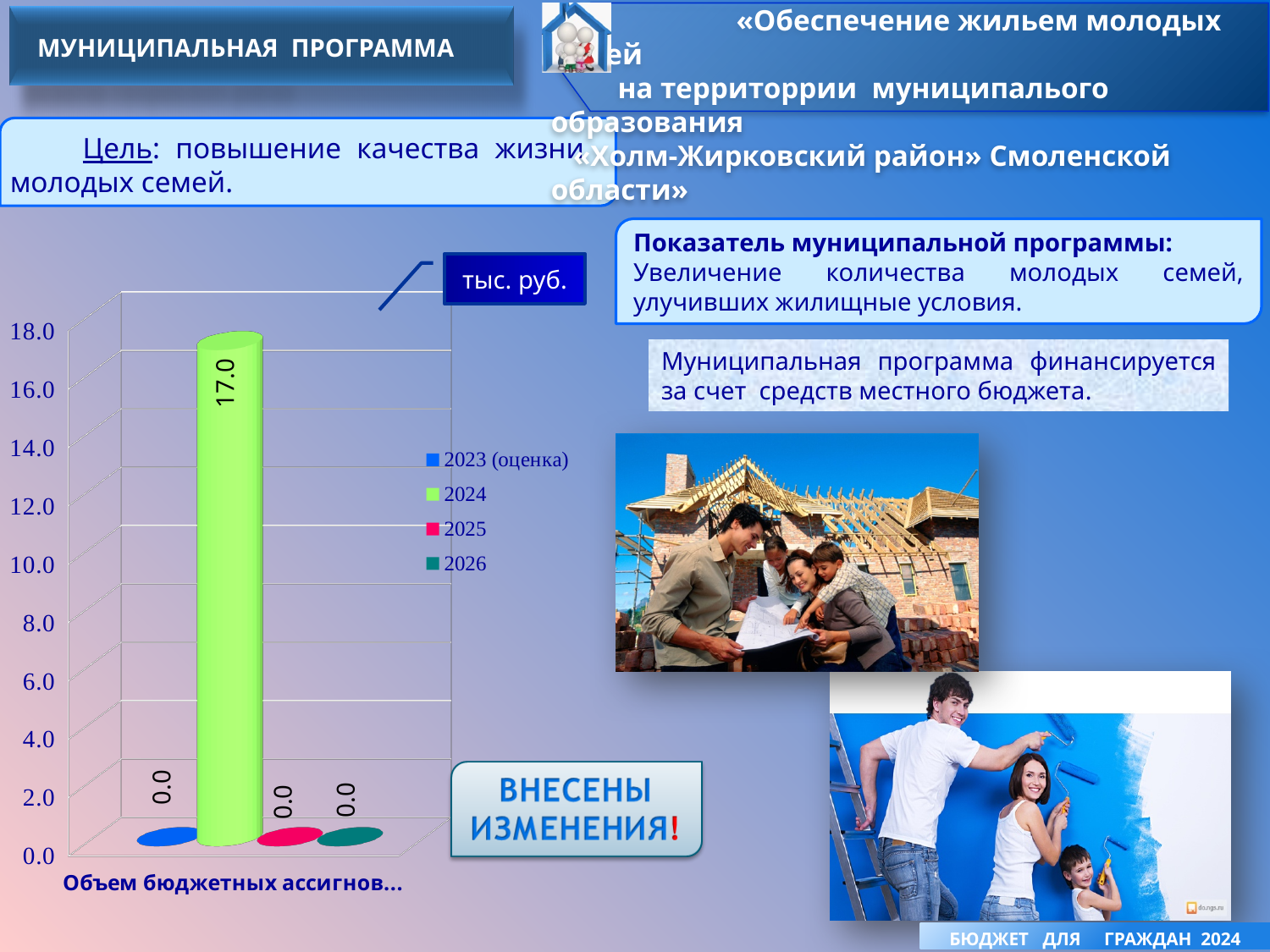
Which series has the highest value on the chart? 2024 What is the value for 2026 on the chart? 0.0 What is the value for 2025 on the chart? 0.0 What unit of measurement is indicated for the chart values? тыс. руб. What kind of chart is shown on the slide? bar chart Which is larger, the value for 2024 or the value for 2023 (оценка)? 2024 Is the value for 2024 greater or less than 16.0? greater What is the value for 2023 (оценка) on the chart? 0.0 What is the difference between the values for 2024 and 2025? 17.0 What is the value for 2024 on the chart? 17.0 How many series does the chart legend list? 4 What is the highest value shown on the chart's vertical axis? 18.0